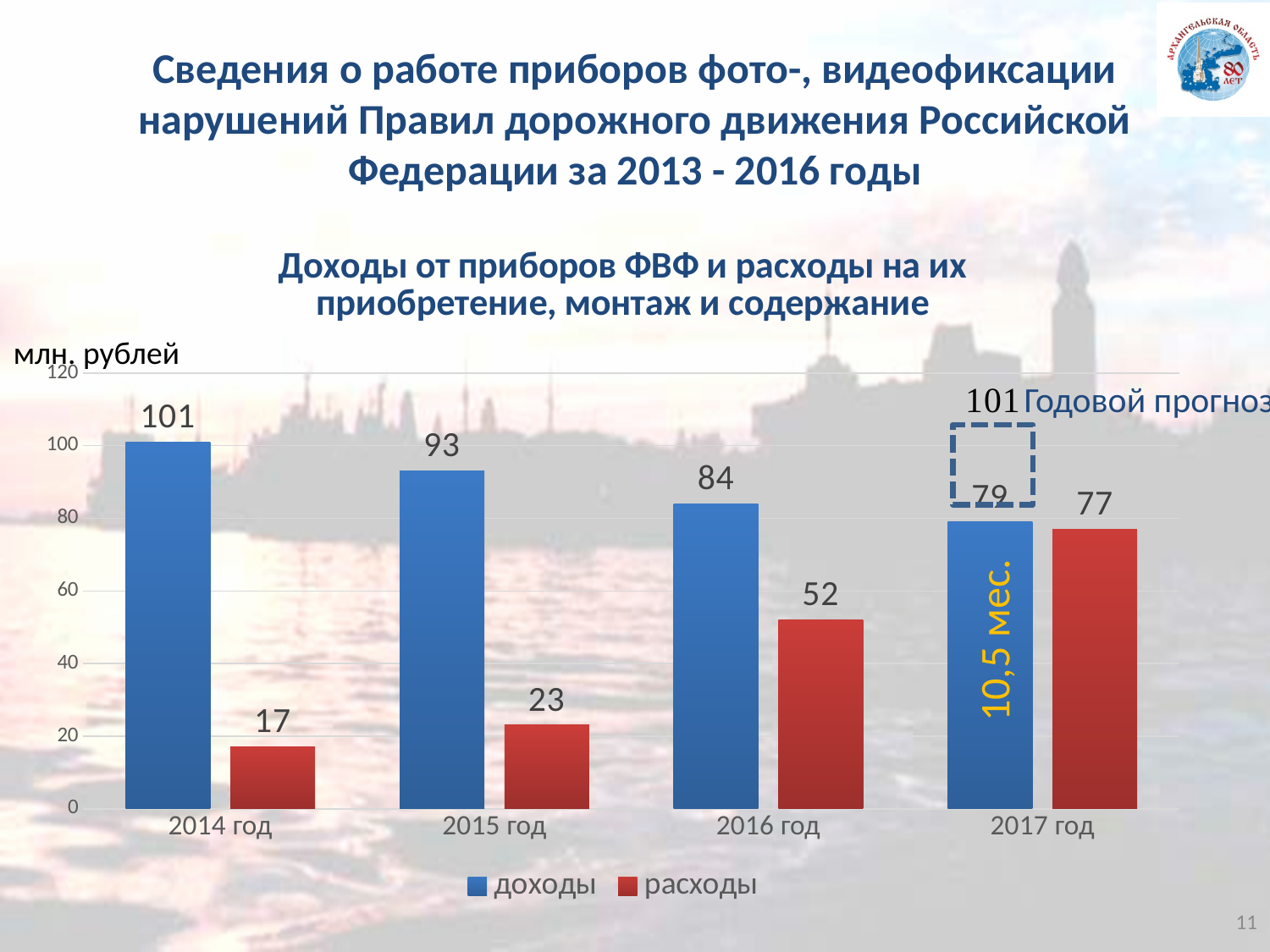
What unit is given for the values on the chart? млн. рублей What is the value of доходы for 2014 год? 101 What type of chart is shown on the slide? bar chart Which year has the lowest value of доходы? 2017 год What is the difference between доходы and расходы in 2015 год? 70 Do the values of доходы rise or fall from 2014 год to 2017 год? fall What is the value of расходы for 2017 год? 77 How many series does the legend list? 2 Which is larger in 2016 год, доходы or расходы? доходы Which year has the highest value of расходы? 2017 год How many year categories are shown on the x axis? 4 What is the value of расходы for 2016 год? 52